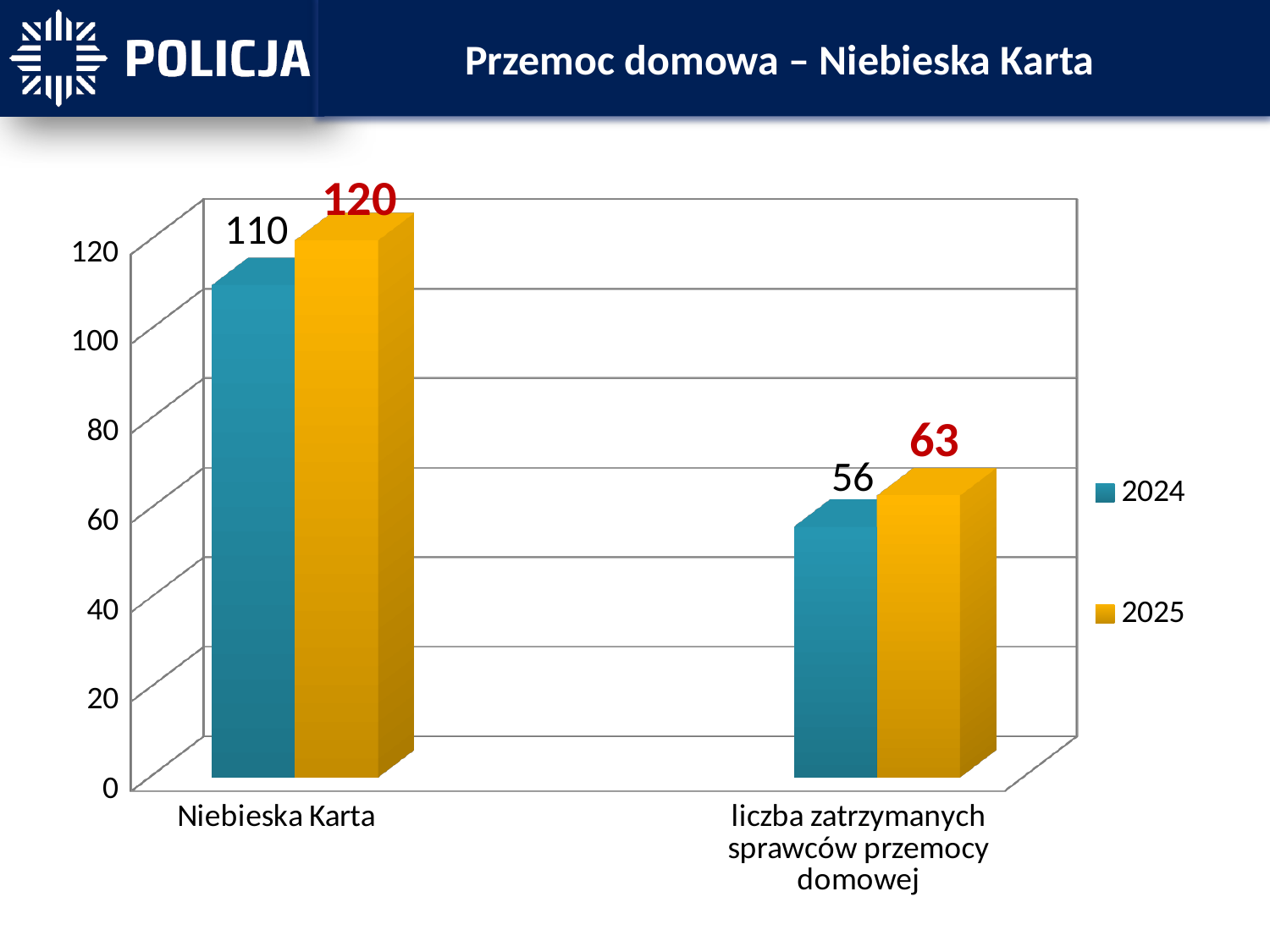
What is the value for Niebieska Karta in 2024? 110 Which category has the lowest value in the 2024 series? liczba zatrzymanych sprawców przemocy domowej What is the difference between the 2025 and 2024 values for liczba zatrzymanych sprawców przemocy domowej? 7 What kind of chart is shown on the slide? bar chart What is the value for liczba zatrzymanych sprawców przemocy domowej in 2025? 63 What is the value for liczba zatrzymanych sprawców przemocy domowej in 2024? 56 What is the value for Niebieska Karta in 2025? 120 What is the difference between the 2025 and 2024 values for Niebieska Karta? 10 How many categories are shown on the x axis? 2 Which is larger for Niebieska Karta: the 2024 value or the 2025 value? 2025 Which category has the highest value in the 2025 series? Niebieska Karta How many series does the legend list? 2